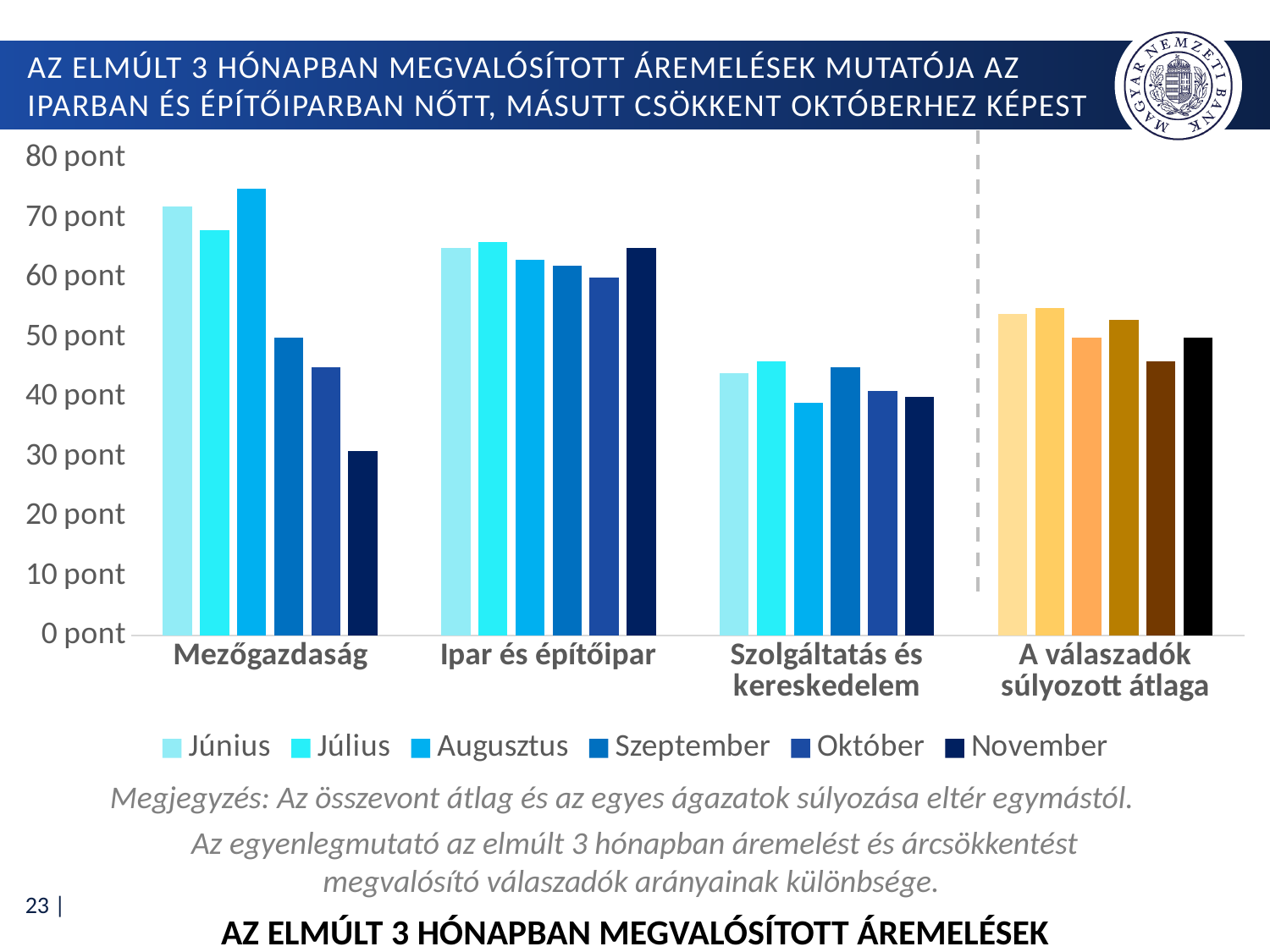
Which month has the lowest value in the Mezőgazdaság category? November How many series does the legend list? 6 Which month has the highest value in the Mezőgazdaság category? Augusztus Is the November value for Ipar és építőipar greater or less than 60 pont? greater Which is larger: the Június value for Mezőgazdaság or the Június value for Ipar és építőipar? Mezőgazdaság Is the Június value for Szolgáltatás és kereskedelem greater or less than 40 pont? greater Is the Október value for Mezőgazdaság greater or less than 50 pont? less How many categories are shown on the x axis? 4 Do the values for Mezőgazdaság rise or fall from Augusztus to November? fall Which month is shown in the darkest navy colour in the legend? November What kind of chart is shown on the slide? bar chart